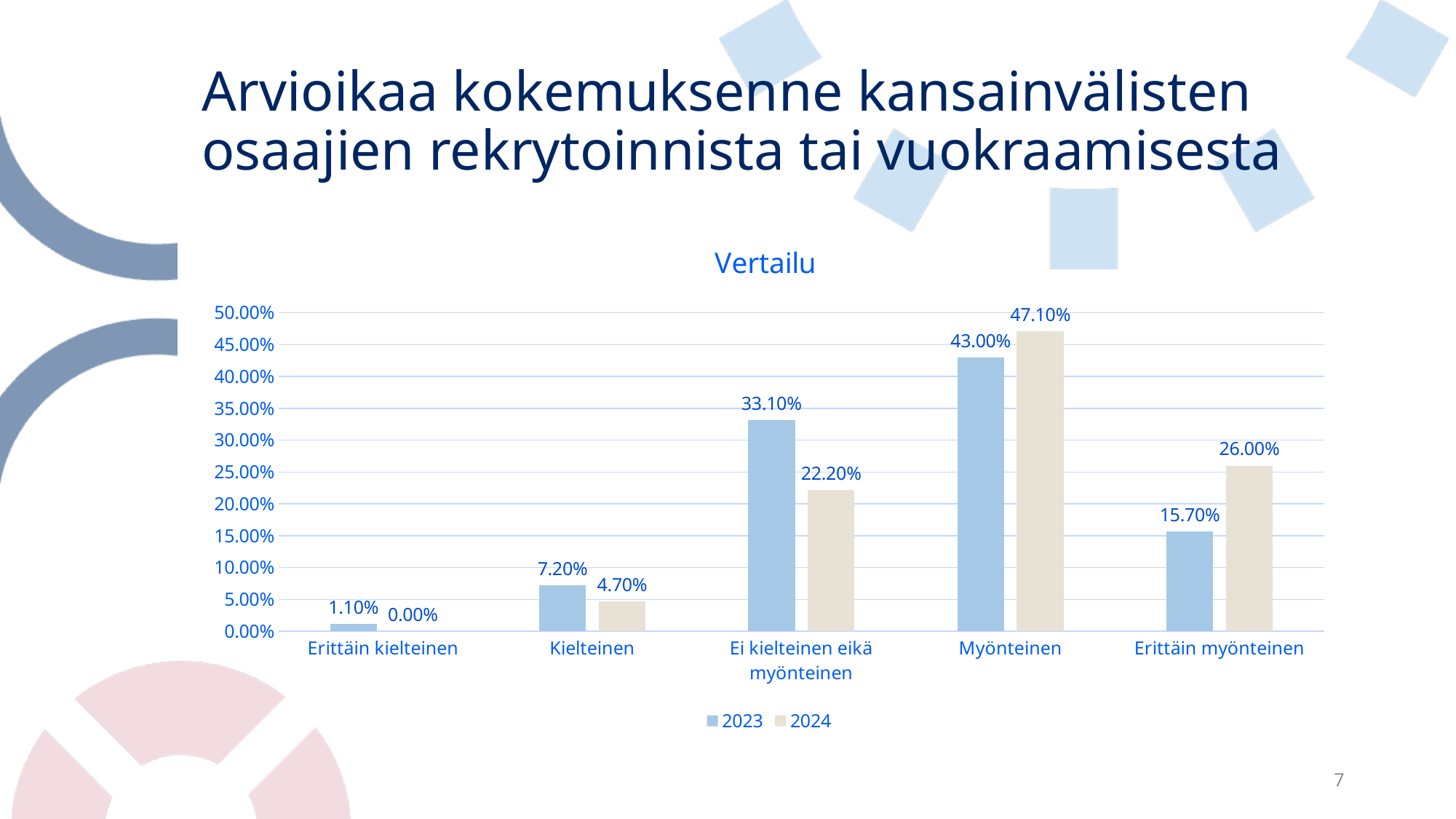
What is the value for Erittäin kielteinen in the 2024 series? 0.00% How many series does the legend list? 2 Which category has the highest value in the 2023 series? Myönteinen What is the title of the chart? Vertailu Which is larger for Ei kielteinen eikä myönteinen, the 2023 value or the 2024 value? 2023 How many categories are shown on the x axis? 5 What is the difference between the 2024 and 2023 values for Erittäin myönteinen? 10.30% What kind of chart is shown on the slide? bar chart What is the value for Ei kielteinen eikä myönteinen in the 2023 series? 33.10% Is the 2023 value for Kielteinen greater or less than 10.00%? less Which category has the lowest value in the 2024 series? Erittäin kielteinen What is the value for Myönteinen in the 2024 series? 47.10%